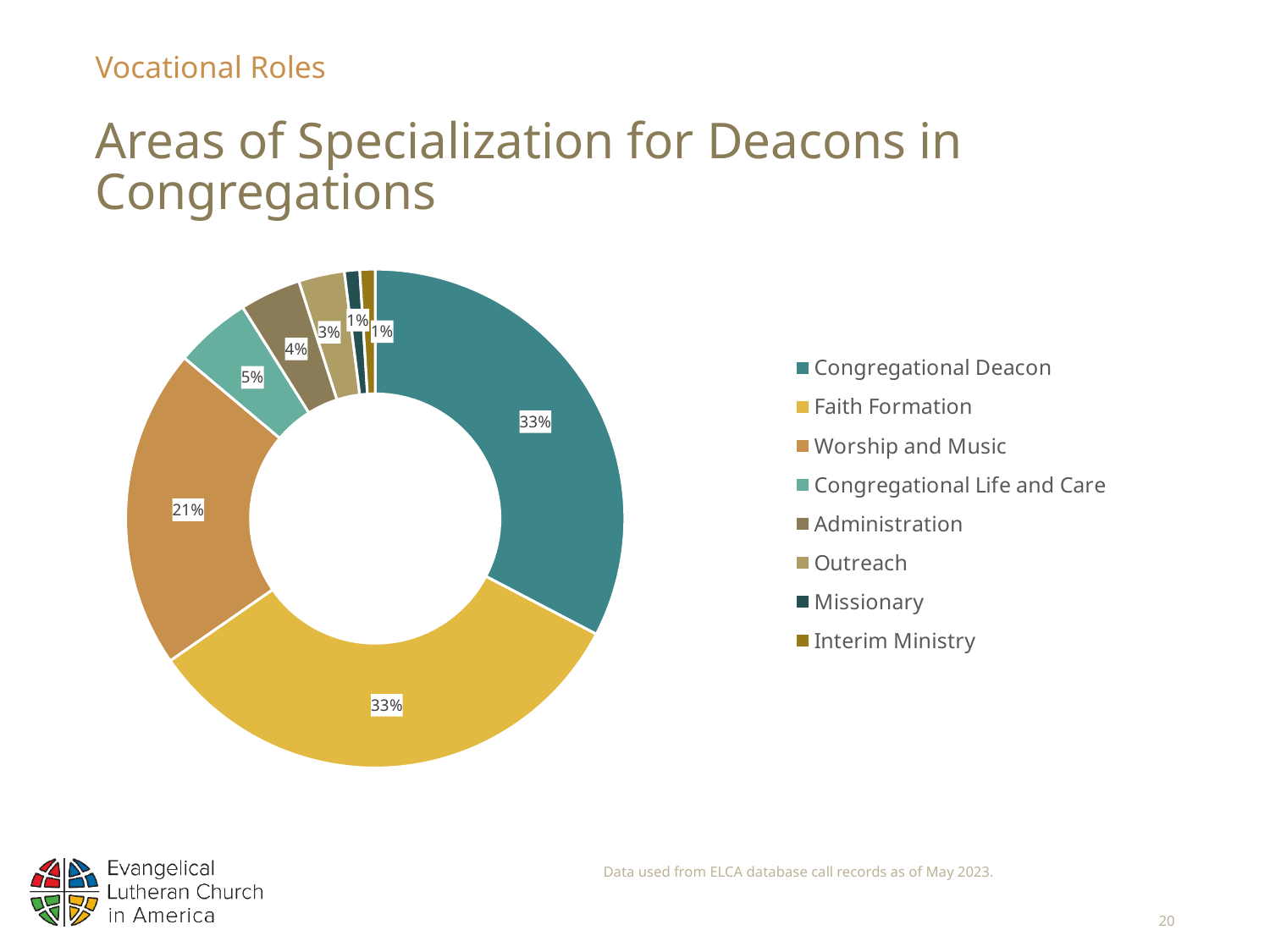
What is the difference between the Faith Formation share and the Worship and Music share? 12 percentage points What share of the chart does Faith Formation represent? 33% What kind of chart is shown on the slide? doughnut chart What is the value shown for Administration? 4% What percentage is labelled for Outreach? 3% What is the value for Missionary? 1% What share does Congregational Life and Care have in the chart? 5% How many categories does the chart show? 8 Which is larger, Worship and Music or Congregational Life and Care? Worship and Music What percentage of the chart is Worship and Music? 21% Which legend entry is listed last? Interim Ministry What is the title of the chart on the slide? Areas of Specialization for Deacons in Congregations